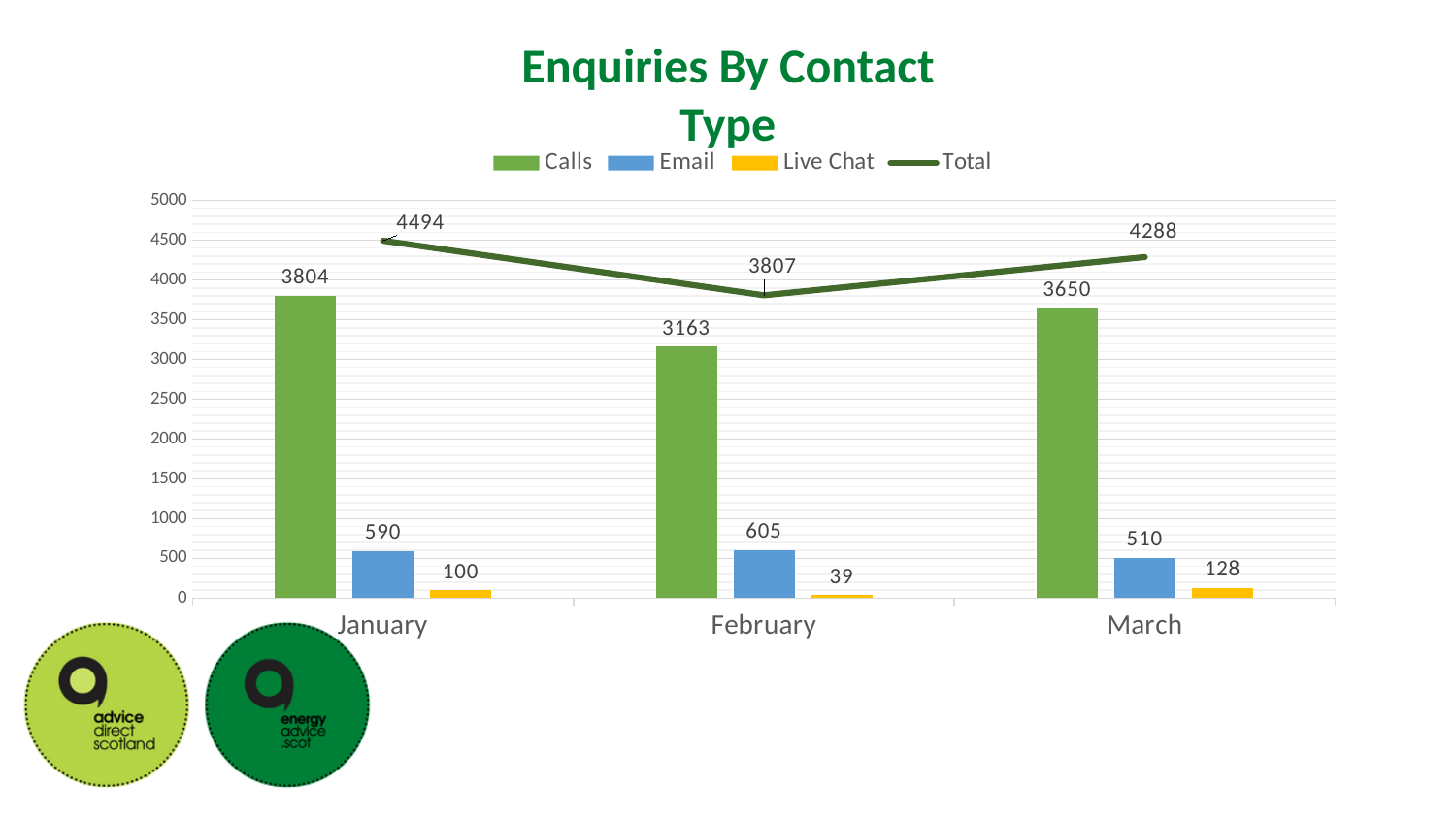
Which month has the highest Total? January Which month has the lowest Live Chat value? February Which is larger, Email in January or Email in March? Email in January How many series does the legend list? 4 What is the value for Calls in January? 3804 What kind of chart is this? Combined bar and line chart What is the value for Email in February? 605 What is the title of the chart? Enquiries By Contact Type What is the difference between Calls in January and Calls in February? 641 What is the Total value for February? 3807 How many months are shown on the x axis? 3 What is the value for Live Chat in March? 128